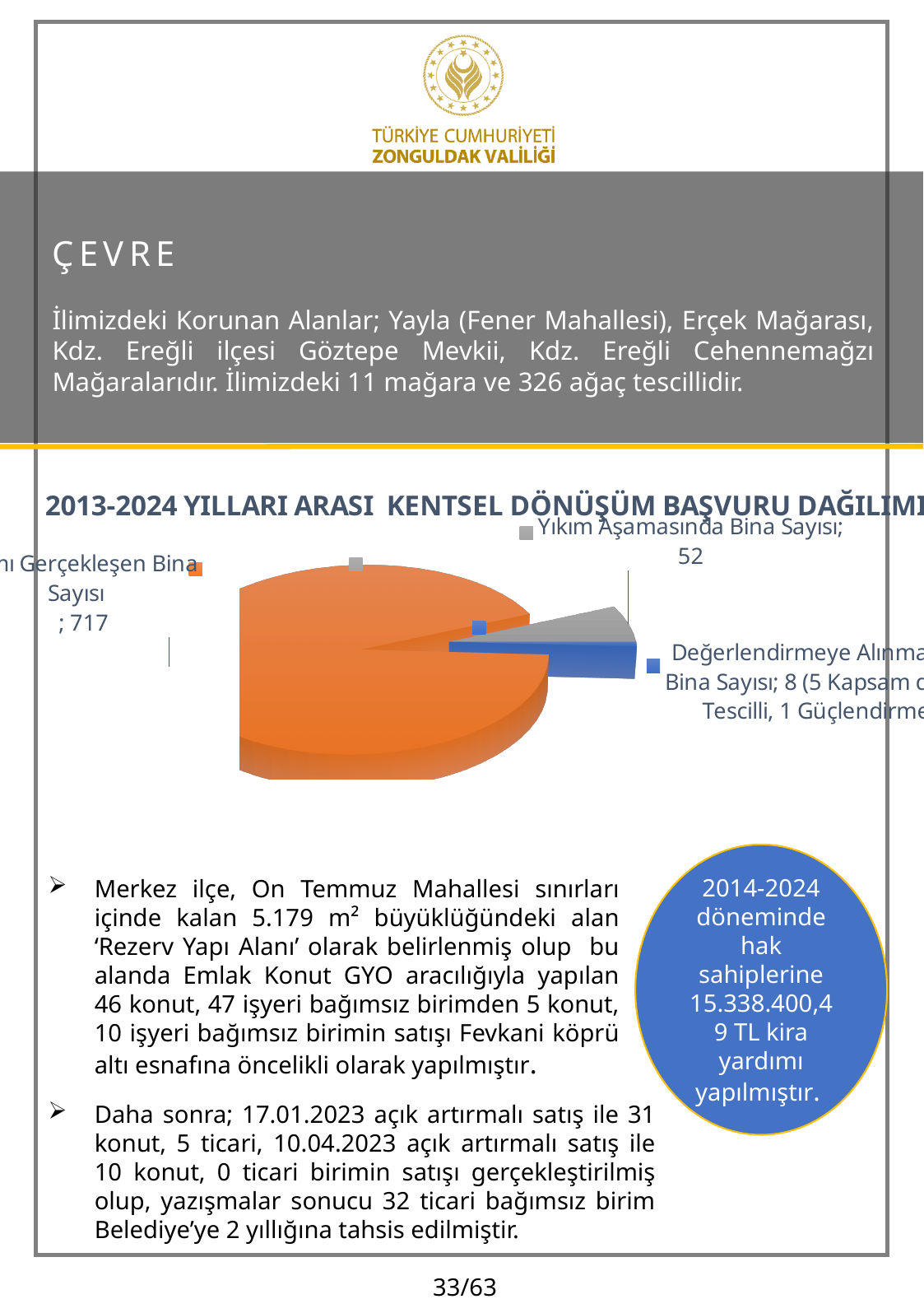
What value is shown for the orange slice ('Gerçekleşen Bina Sayısı') in the pie chart? 717 How many slices does the pie chart have? 3 What is the value for 'Yıkım Aşamasında Bina Sayısı' in the pie chart? 52 Which is larger: 'Yıkım Aşamasında Bina Sayısı' or the blue slice ('Değerlendirmeye Alınma... Bina Sayısı')? Yıkım Aşamasında Bina Sayısı What kind of chart is shown on the slide? Pie chart What is the difference between the orange slice value (717) and 'Yıkım Aşamasında Bina Sayısı' (52)? 665 Which slice of the pie chart has the largest value? Gerçekleşen Bina Sayısı (717) What year range is given in the pie chart's title? 2013-2024 What colour is the slice for 'Yıkım Aşamasında Bina Sayısı'? Gray What value is shown for the blue slice ('Değerlendirmeye Alınma... Bina Sayısı') in the pie chart? 8 What is the difference between 'Yıkım Aşamasında Bina Sayısı' and the blue slice value? 44 Which slice of the pie chart has the smallest value? Değerlendirmeye Alınma... Bina Sayısı (8)